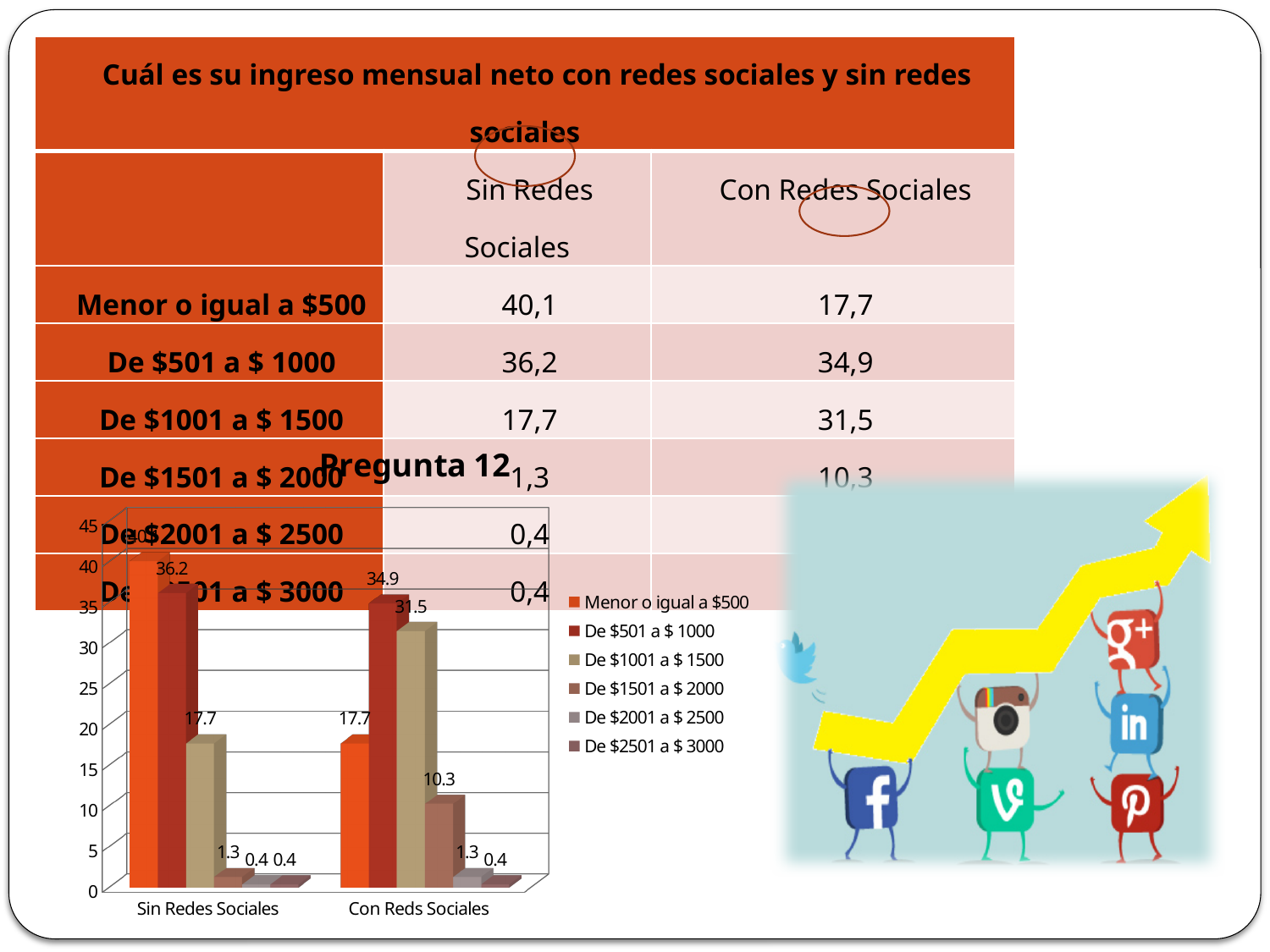
Which is larger: 'De $1001 a $ 1500' for 'Sin Redes Sociales' or 'De $1001 a $ 1500' for 'Con Reds Sociales'? Con Reds Sociales How many categories are shown on the x axis of the chart? 2 What is the value for 'De $1501 a $ 2000' in the 'Con Reds Sociales' category? 10.3 How many series does the chart legend list? 6 What is the difference between 'De $501 a $ 1000' and 'De $1001 a $ 1500' in the 'Con Reds Sociales' category? 3.4 What type of chart is shown on the slide? bar chart What is the value for 'De $1501 a $ 2000' in the 'Sin Redes Sociales' category? 1.3 Is the value for 'Menor o igual a $500' in the 'Sin Redes Sociales' category greater or less than 35? greater What is the value for 'Menor o igual a $500' in the 'Con Reds Sociales' category? 17.7 Which series has the highest value in the 'Con Reds Sociales' category? De $501 a $ 1000 What is the value for 'De $501 a $ 1000' in the 'Sin Redes Sociales' category? 36.2 What is the value for 'De $1001 a $ 1500' in the 'Con Reds Sociales' category? 31.5